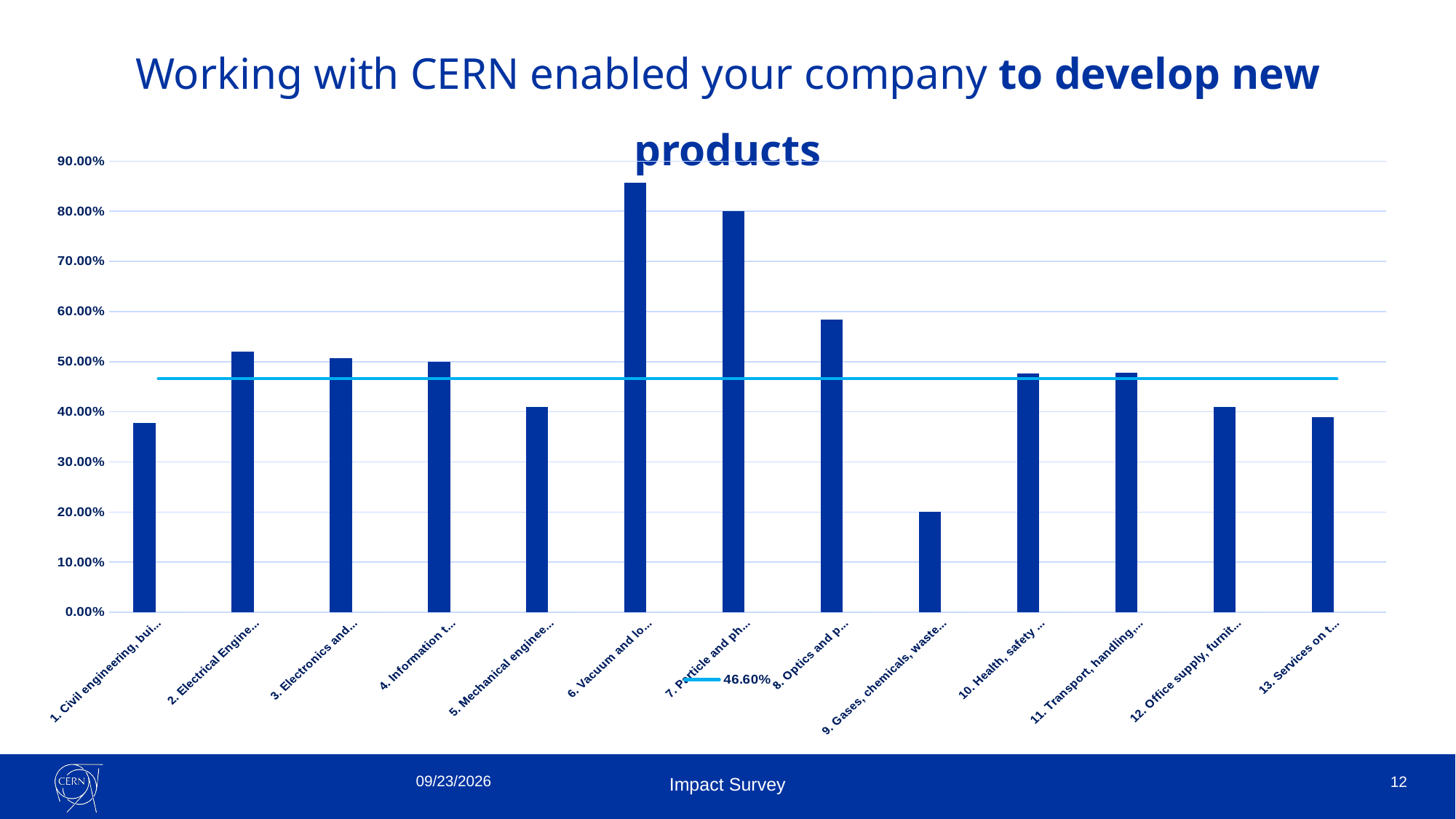
Is the value for category 6 (Vacuum and lo...) greater or less than 80.00%? greater Which category has the lowest bar in the chart? 9. Gases, chemicals, waste... Is the value for category 1 (Civil engineering, bui...) greater or less than 40.00%? less Is the value for category 9 (Gases, chemicals, waste...) greater or less than 30.00%? less Which is larger: the value for category 2 (Electrical Engine...) or category 5 (Mechanical enginee...)? 2. Electrical Engine... Which is larger: the value for category 7 (Particle and ph...) or category 8 (Optics and p...)? 7. Particle and ph... What is the highest value shown on the vertical axis of the chart? 90.00% Which category has the highest bar in the chart? 6. Vacuum and lo... What kind of chart is shown on the slide? bar chart What value is shown in the legend for the horizontal line across the chart? 46.60% How many categories (bars) are plotted in the chart? 13